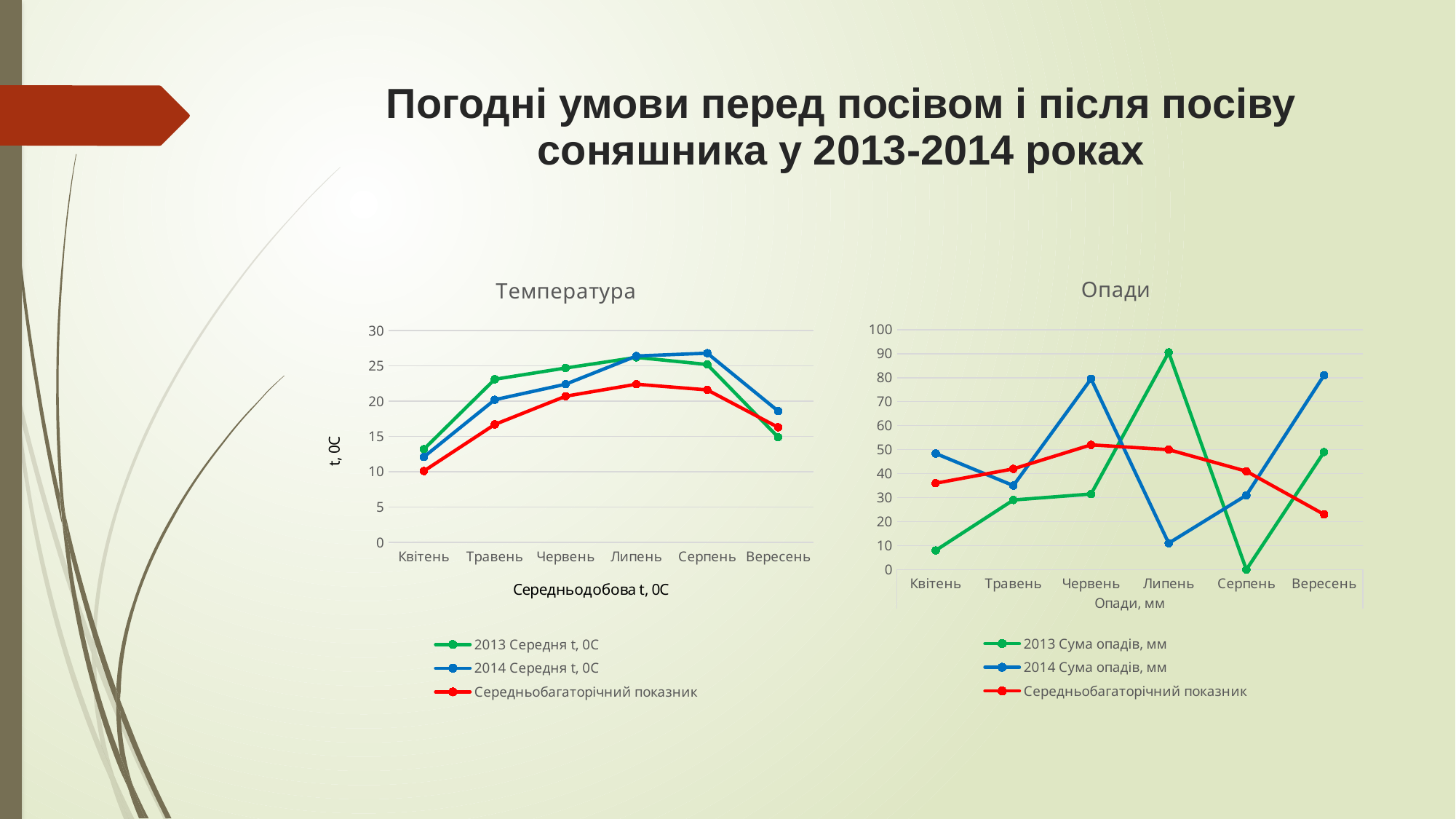
In the "Опади" chart, which series has the larger value in Червень: "2013 Сума опадів, мм" or "2014 Сума опадів, мм"? 2014 Сума опадів, мм In the "Температура" chart, is the value for "2013 Середня t, 0C" in Квітень greater or less than 15? less In the "Опади" chart, is the value for "2014 Сума опадів, мм" in Вересень greater or less than 70? greater In the "Температура" chart, does the "Середньобагаторічний показник" line rise or fall from Квітень to Липень? rises In the "Опади" chart, is the value for "2013 Сума опадів, мм" in Липень greater or less than 80? greater What kind of chart is the "Температура" chart? line chart In the "Опади" chart, which month has the highest value for "2013 Сума опадів, мм"? Липень In the "Опади" chart, which month has the lowest value for "2013 Сума опадів, мм"? Серпень How many months are shown on the x axis of the "Опади" chart? 6 In the "Температура" chart, which month has the highest value for "2013 Середня t, 0C"? Липень What is the vertical axis title of the "Температура" chart? t, 0C How many series does the legend of the "Температура" chart list? 3